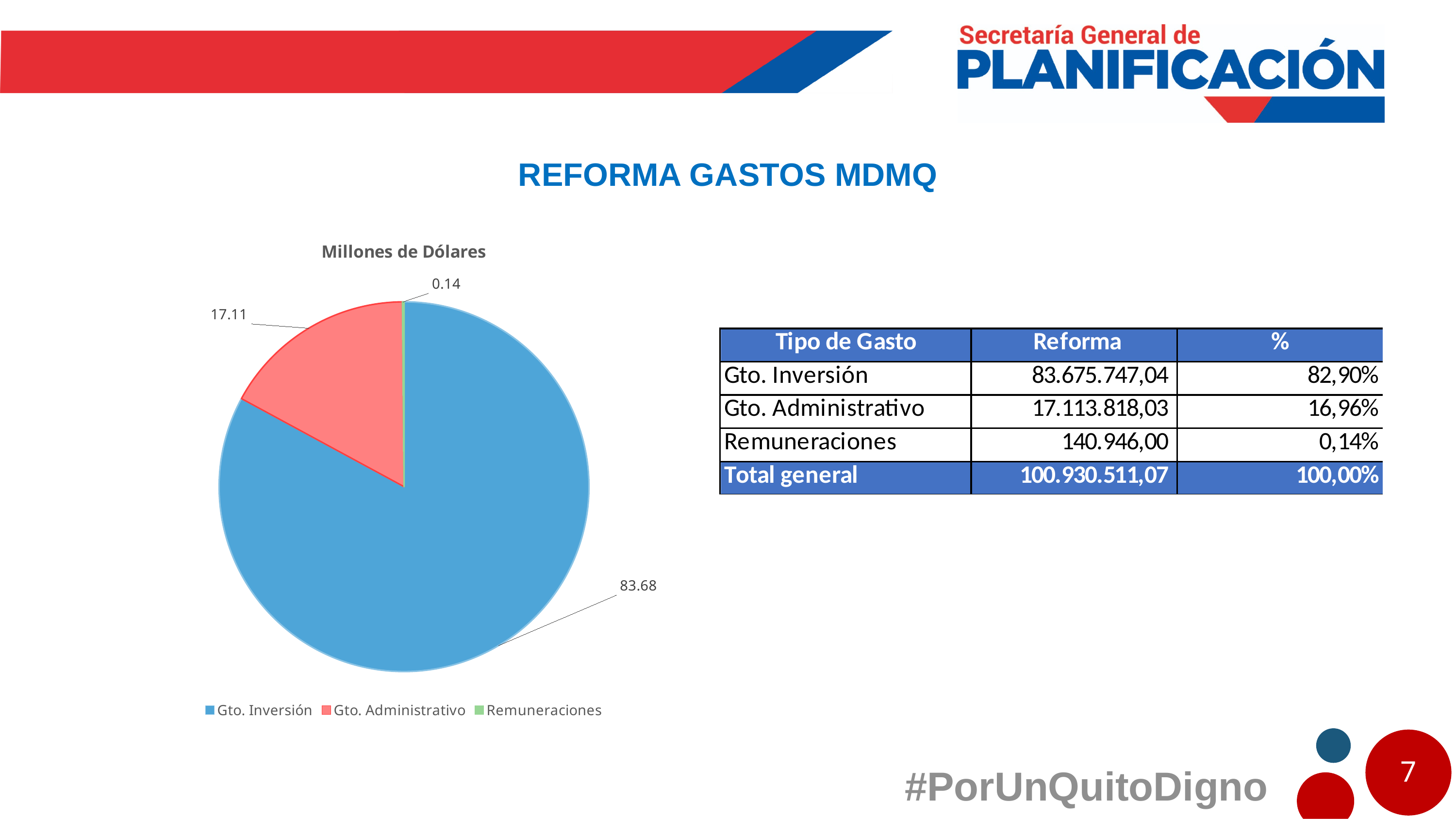
What is the value shown for Remuneraciones in the pie chart? 0.14 What is the difference between the values for Gto. Inversión and Gto. Administrativo in the pie chart? 66.57 What is the total of all the slice values in the pie chart? 100.93 How many slices does the pie chart have? 3 Which category has the largest slice in the pie chart? Gto. Inversión Which is larger in the pie chart, Gto. Administrativo or Remuneraciones? Gto. Administrativo What is the title of the pie chart? Millones de Dólares What is the value shown for Gto. Administrativo in the pie chart? 17.11 Which category has the smallest slice in the pie chart? Remuneraciones What is the value shown for Gto. Inversión in the pie chart? 83.68 How many entries does the pie chart legend list? 3 What kind of chart is shown on the slide? Pie chart